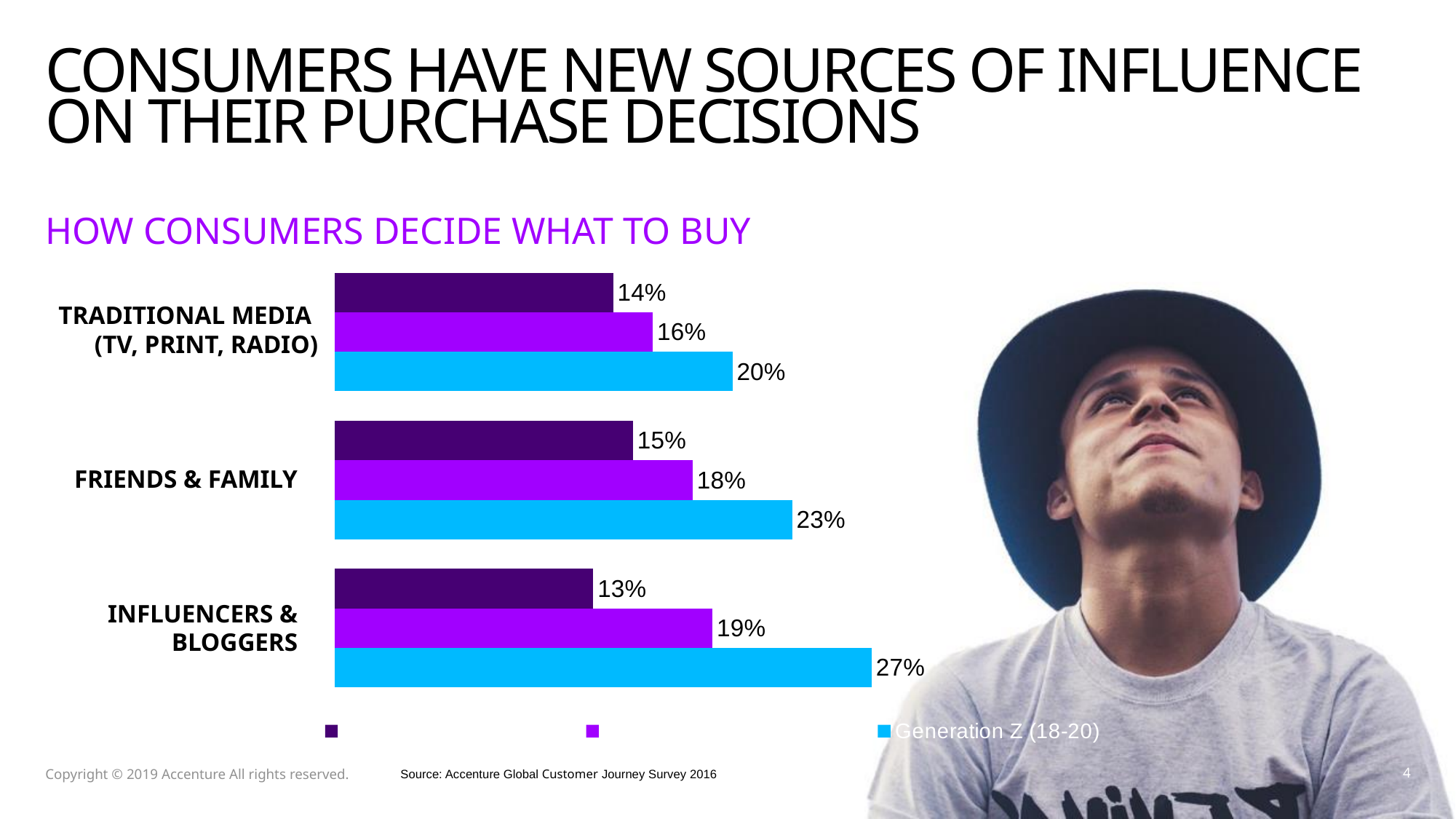
What kind of chart is shown on the slide? bar chart What is the Generation Z (18-20) value for Influencers & Bloggers? 27% What is the Generation Z (18-20) value for Friends & Family? 23% Which is larger: the Generation Z (18-20) value for Friends & Family or the dark purple bar for Friends & Family? Generation Z (18-20) How many categories does the chart show? 3 What is the title of the chart? HOW CONSUMERS DECIDE WHAT TO BUY What is the value of the dark purple bar for Influencers & Bloggers? 13% What is the Generation Z (18-20) value for Traditional Media (TV, Print, Radio)? 20% Which category has the highest Generation Z (18-20) value? Influencers & Bloggers What is the difference between the Generation Z (18-20) value for Influencers & Bloggers and for Traditional Media (TV, Print, Radio)? 7% Which category has the lowest value for the dark purple series? Influencers & Bloggers How many series does the legend list? 3